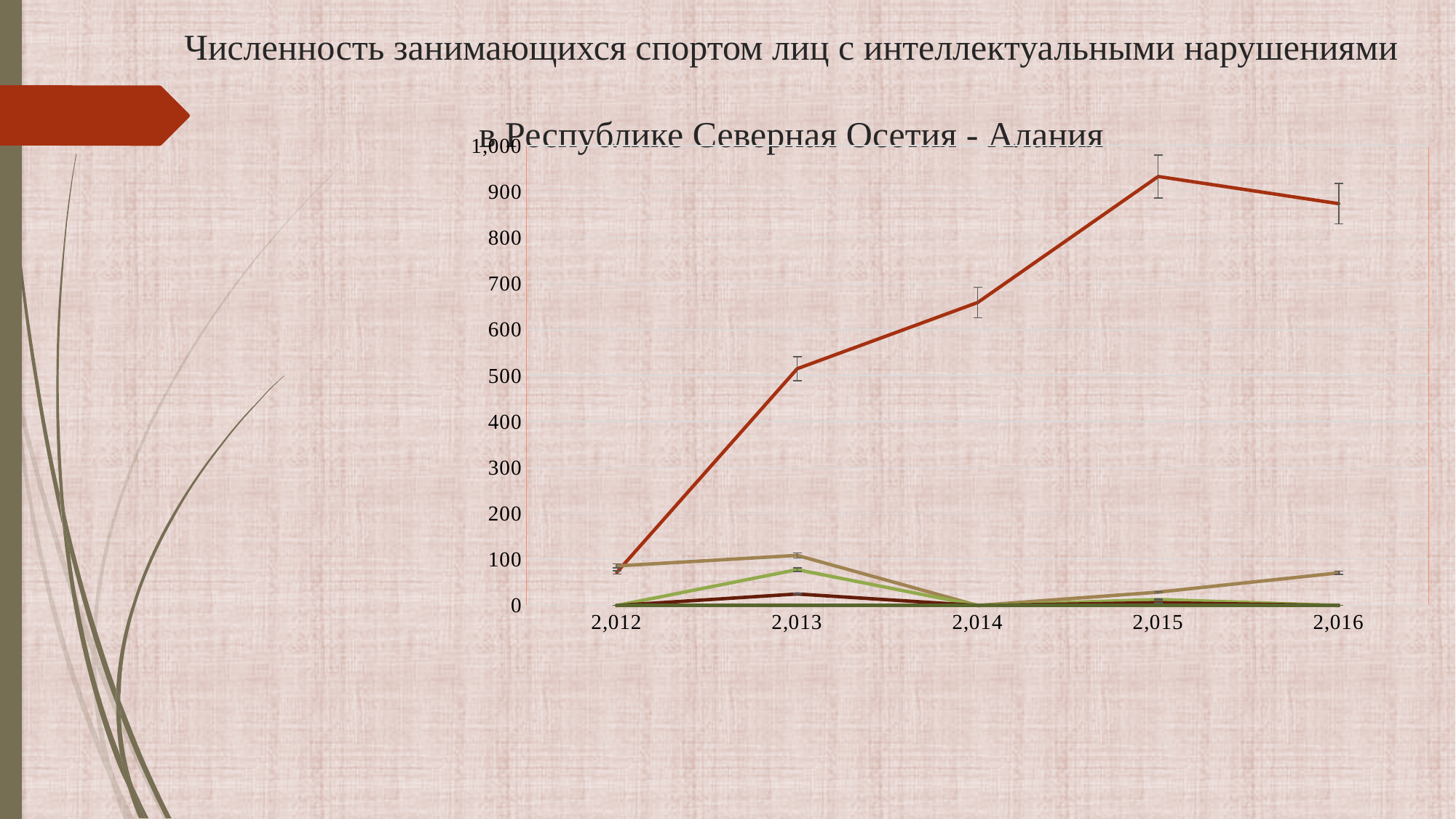
What is the title of the slide? Численность занимающихся спортом лиц с интеллектуальными нарушениями в Республике Северная Осетия - Алания Is the value of the red line for 2,016 greater or less than 900? less Is the value of the red line for 2,012 greater or less than 100? less In which year does the red line have its lowest value? 2,012 Does the red line rise or fall between 2,012 and 2,015? rise Is the value of the red line for 2,015 greater or less than 900? greater In which year does the red line reach its highest value? 2,015 Which is larger for the red line: the value for 2,014 or the value for 2,015? 2,015 What kind of chart is shown on the slide? line chart How many years are plotted along the x axis? 5